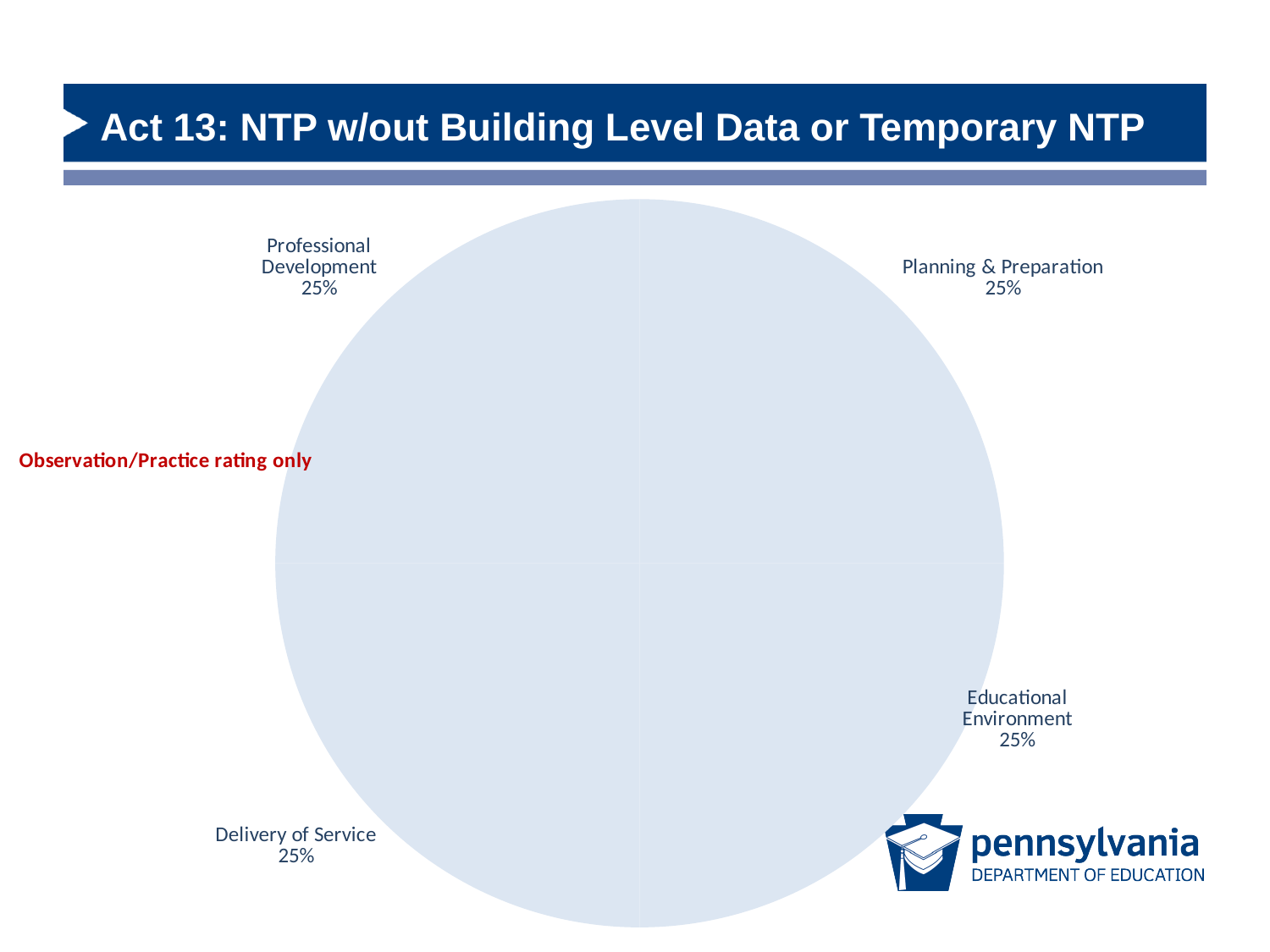
What percentage is shown for Professional Development? 25% What share of the pie does the Delivery of Service slice represent? 25% What percentage is shown for Delivery of Service? 25% What is the title of the slide containing the pie chart? Act 13: NTP w/out Building Level Data or Temporary NTP What kind of chart is shown on the slide? pie chart How many slices does the pie chart have? 4 What does the red text to the left of the pie chart say? Observation/Practice rating only What is the combined share of Professional Development and Delivery of Service? 50% What is the difference between the Planning & Preparation value and the Educational Environment value? 0% What percentage is shown for Educational Environment? 25% What percentage is shown for Planning & Preparation? 25% Do all four slices of the pie chart have the same value? Yes